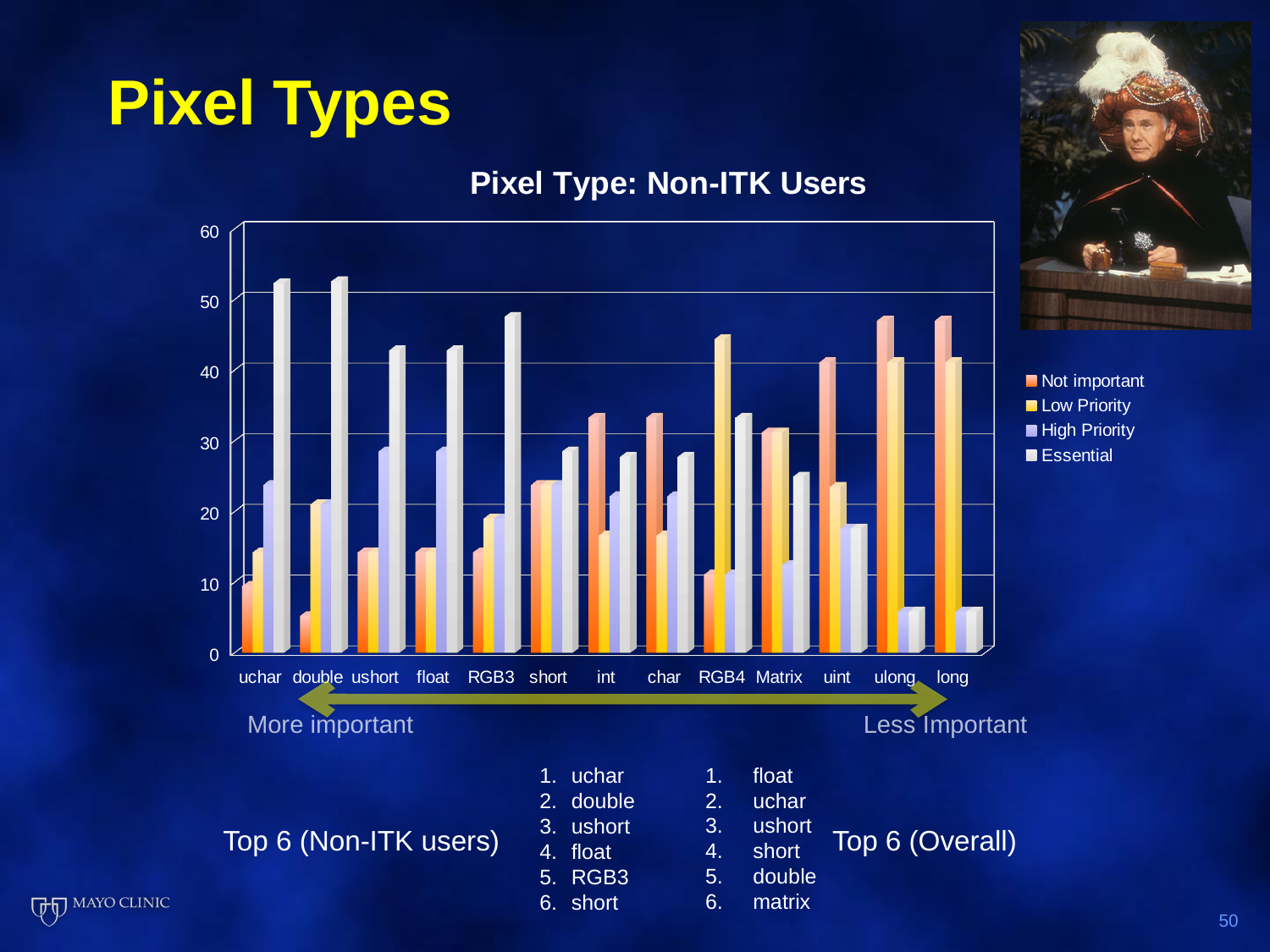
How many pixel type categories are shown on the x axis? 13 Which series is shown in the lightest (grey/white) colour in the legend? Essential Do the Essential values generally rise or fall moving from uchar to long along the x axis? fall What kind of chart is shown on the slide? bar chart What is the title of the chart? Pixel Type: Non-ITK Users Which is larger, the Not important value for uint or the Not important value for uchar? uint Is the Not important value for double greater or less than 10? less Which is larger, the Essential value for uchar or the Essential value for ulong? uchar Is the Essential value for RGB3 greater or less than 40? greater Is the Essential value for ulong greater or less than 10? less How many series does the legend list? 4